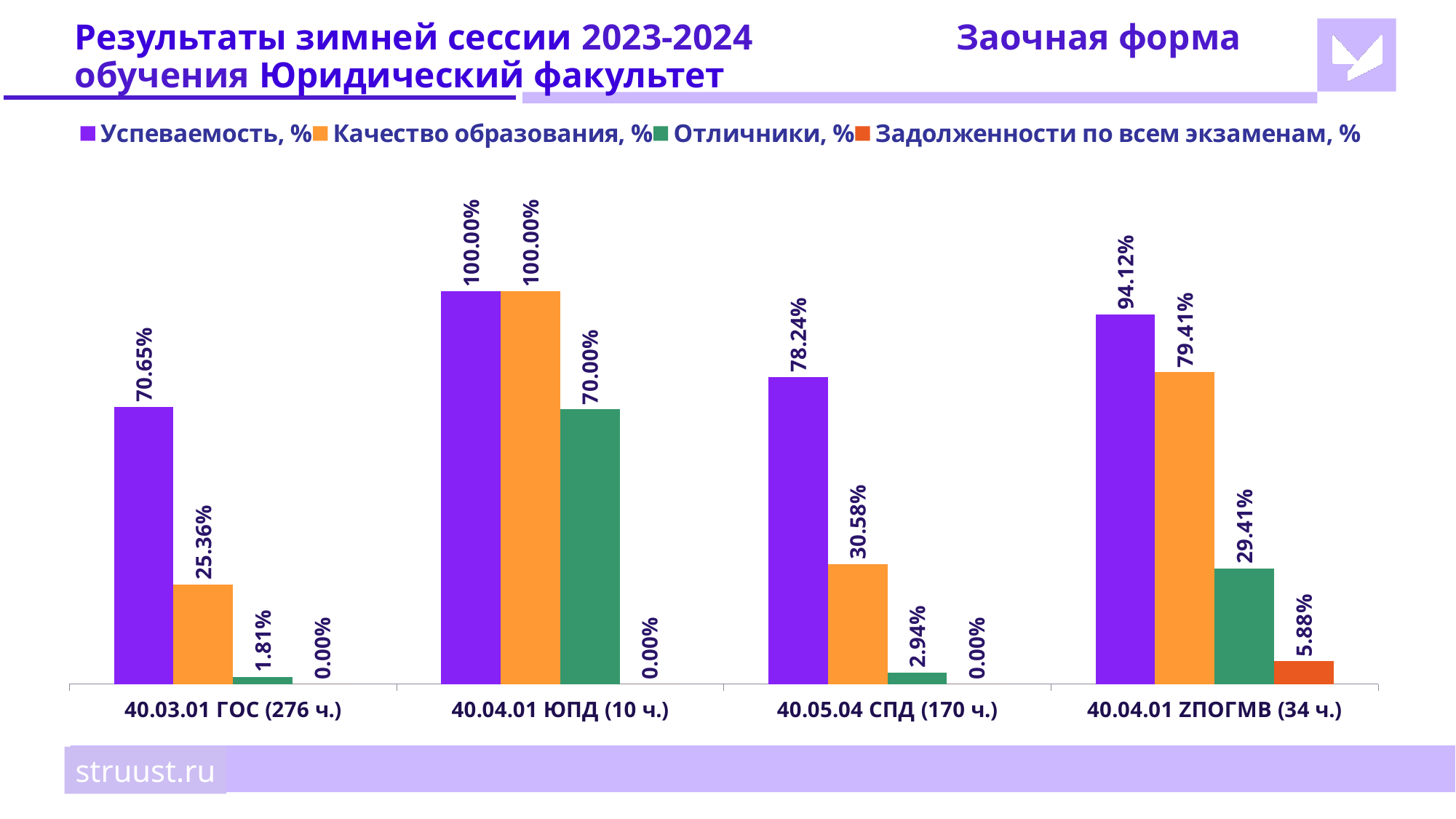
What is the Успеваемость, % value for 40.03.01 ГОС (276 ч.)? 70.65% Which colour represents the Отличники, % series? Green What is the Качество образования, % value for 40.04.01 ZПОГМВ (34 ч.)? 79.41% What is the Задолженности по всем экзаменам, % value for 40.04.01 ZПОГМВ (34 ч.)? 5.88% What is the difference between the Успеваемость, % and Качество образования, % values for 40.05.04 СПД (170 ч.)? 47.66% Which category has the lowest Успеваемость, % value? 40.03.01 ГОС (276 ч.) Which is larger: the Качество образования, % value for 40.03.01 ГОС (276 ч.) or for 40.05.04 СПД (170 ч.)? 40.05.04 СПД (170 ч.) How many categories are shown on the x axis? 4 Which category has the highest Отличники, % value? 40.04.01 ЮПД (10 ч.) What is the Отличники, % value for 40.05.04 СПД (170 ч.)? 2.94% What kind of chart is shown on the slide? Bar chart How many series does the legend list? 4